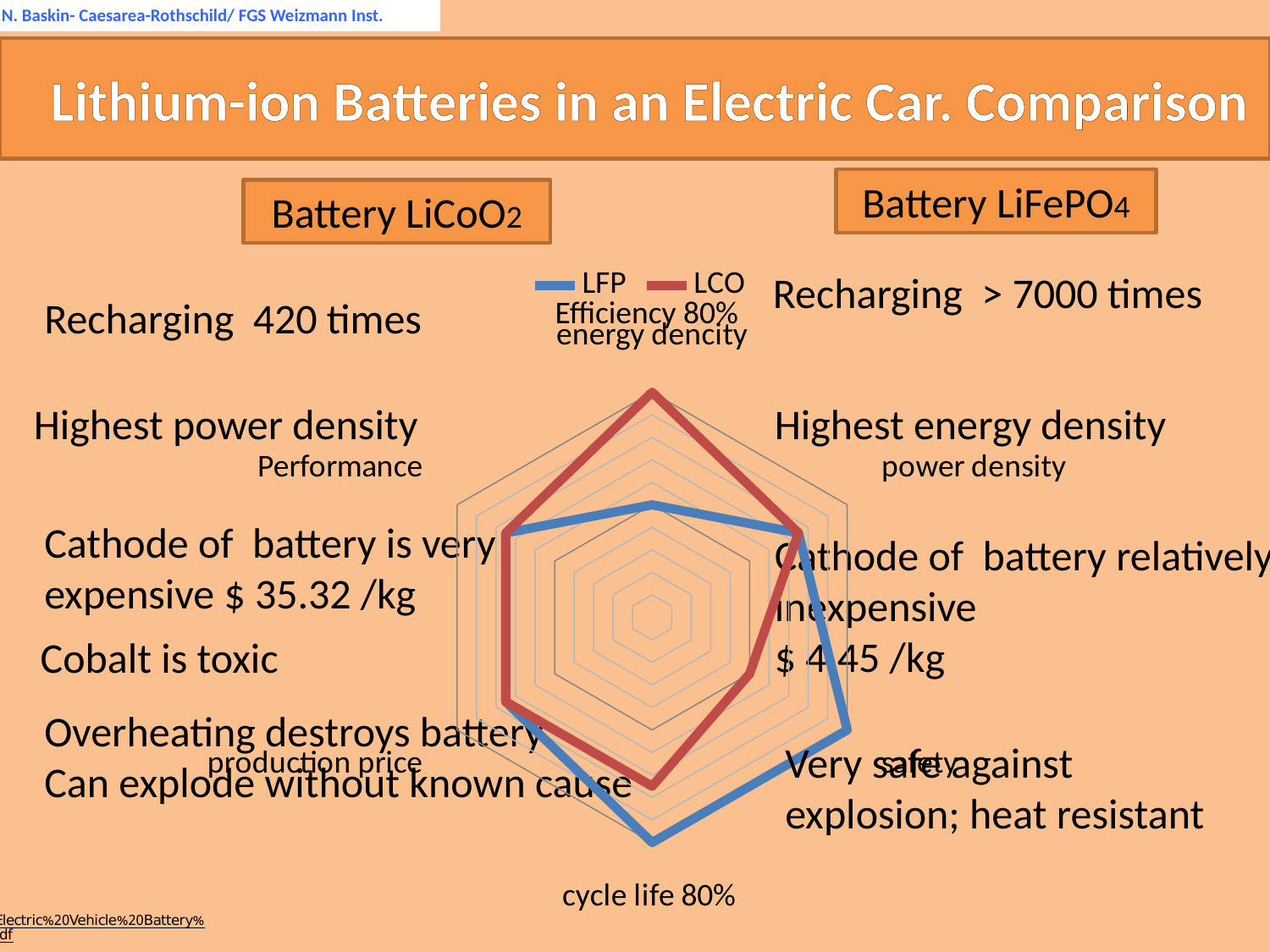
On which axis does the LCO series have its lowest value? safety On the power density axis, which series has the larger value, LFP or LCO? Neither; they are equal Which series is plotted in blue on the radar chart? LFP How many series does the chart legend list? 2 How many axes (categories) does the radar chart have? 6 On the safety axis, which series has the larger value, LFP or LCO? LFP What kind of chart is shown on the slide? radar chart On which axis does the LCO series reach its highest value? energy density Which series is plotted in red on the radar chart? LCO On the cycle life 80% axis, which series has the larger value, LFP or LCO? LFP